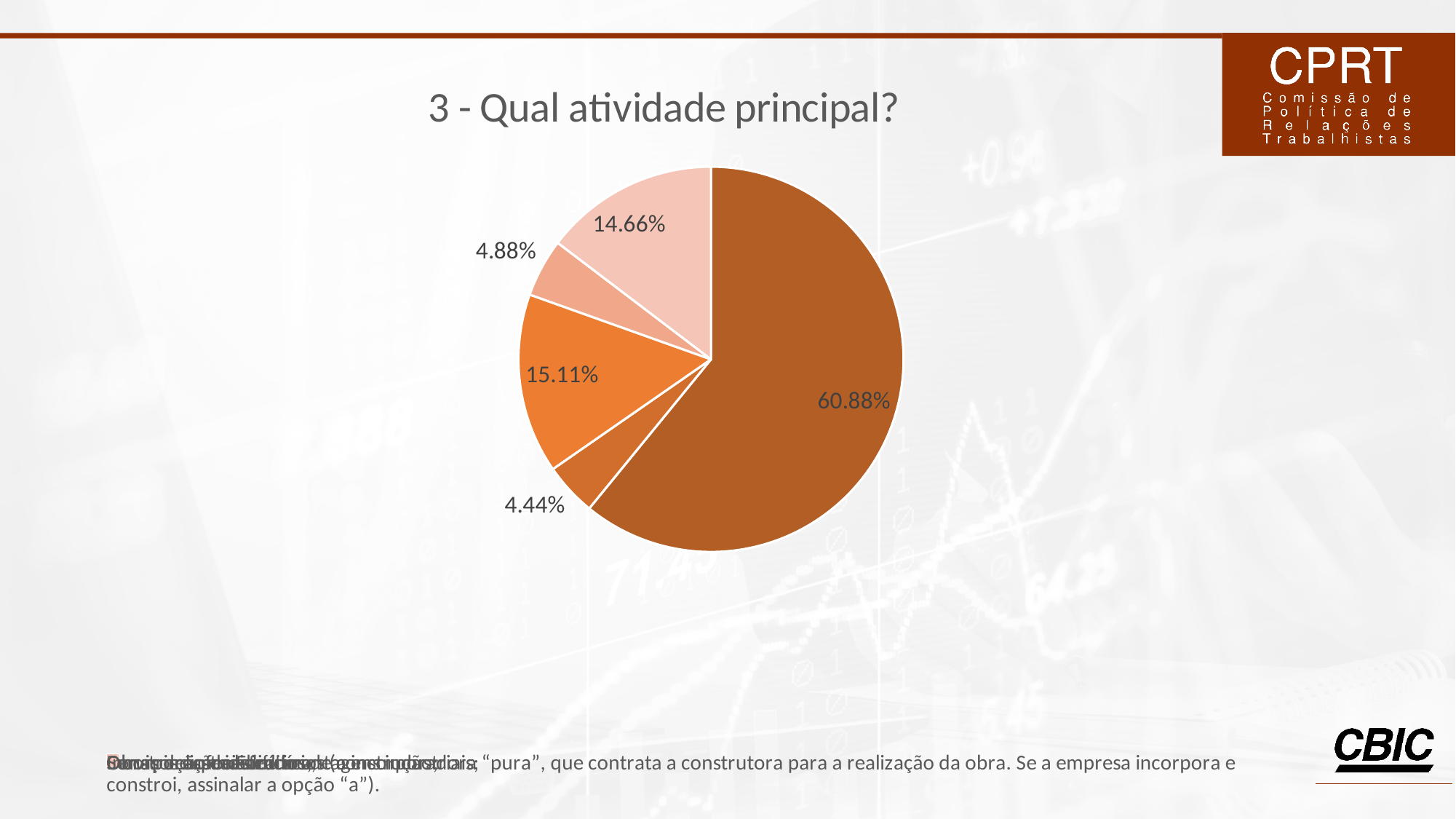
Which is larger: the slice labelled 15.11% or the slice labelled 14.66%? 15.11% What is the value of the lightest-coloured (pale pink) slice at the top of the pie chart? 14.66% What kind of chart is shown on the slide? pie chart How many slices does the pie chart have? 5 Is the largest slice of the pie chart greater or less than 50%? greater What is the title of the chart? 3 - Qual atividade principal? What is the value of the bright orange slice on the left side of the pie chart? 15.11% What is the difference between the slices labelled 4.88% and 4.44%? 0.44% What is the difference between the largest slice (60.88%) and the slice labelled 15.11%? 45.77% What is the value of the smallest slice of the pie chart? 4.44% What is the combined share of the two smallest slices (4.44% and 4.88%)? 9.32% What is the value of the largest slice of the pie chart? 60.88%